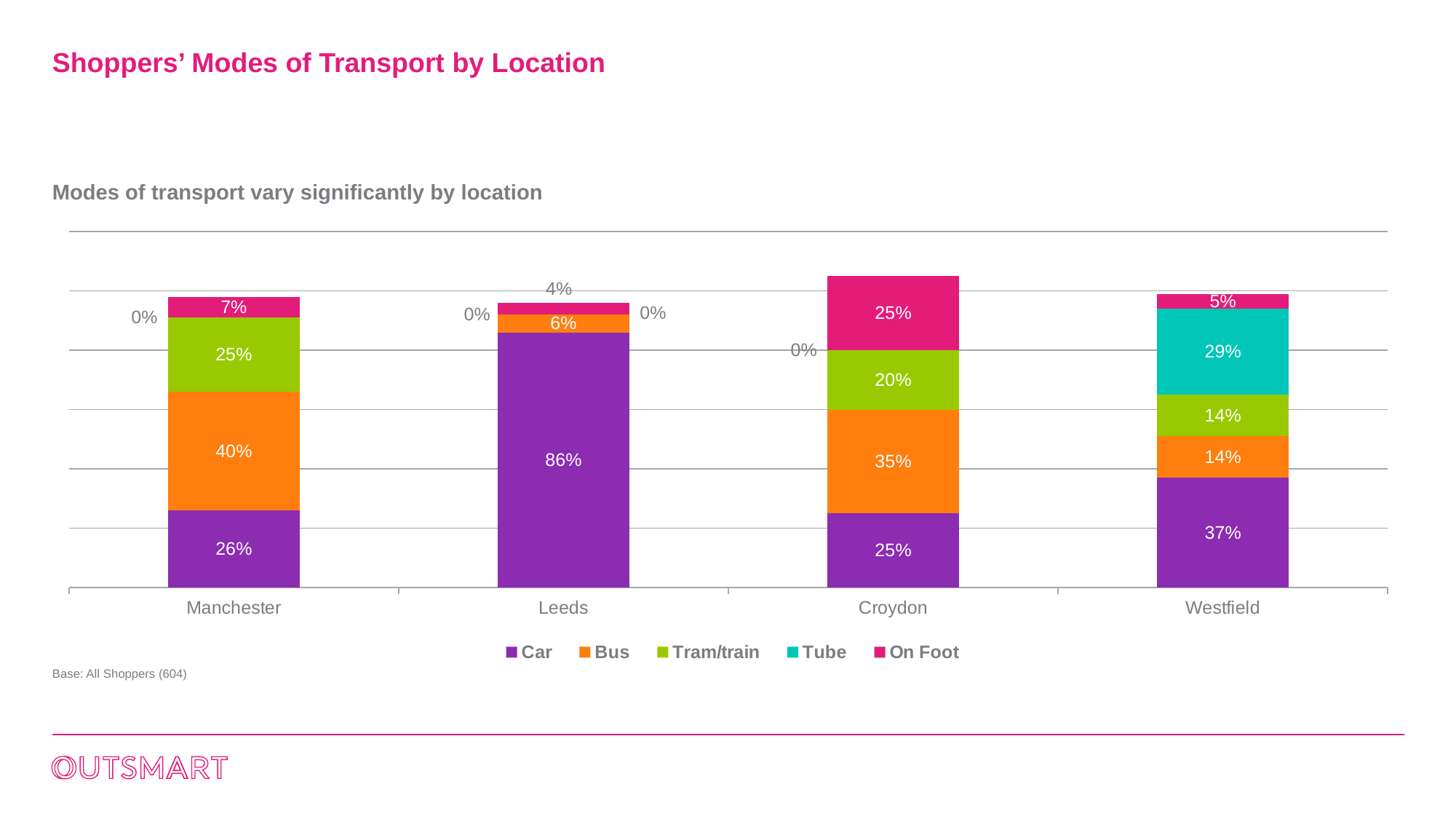
What percentage of shoppers in Leeds travel by Car? 86% What is the difference between the Bus share in Manchester and the Bus share in Croydon? 5% What percentage of Westfield shoppers use the Tube? 29% What kind of chart is shown on the slide? Stacked bar chart How many locations are shown on the x axis? 4 What is the On Foot share for Croydon? 25% How many series does the legend list? 5 Which location has the highest Car share? Leeds What is the title of the slide? Shoppers' Modes of Transport by Location Which has a larger Tram/train share, Manchester or Croydon? Manchester What is the Bus share for Manchester? 40% Which location has the lowest Bus share? Leeds